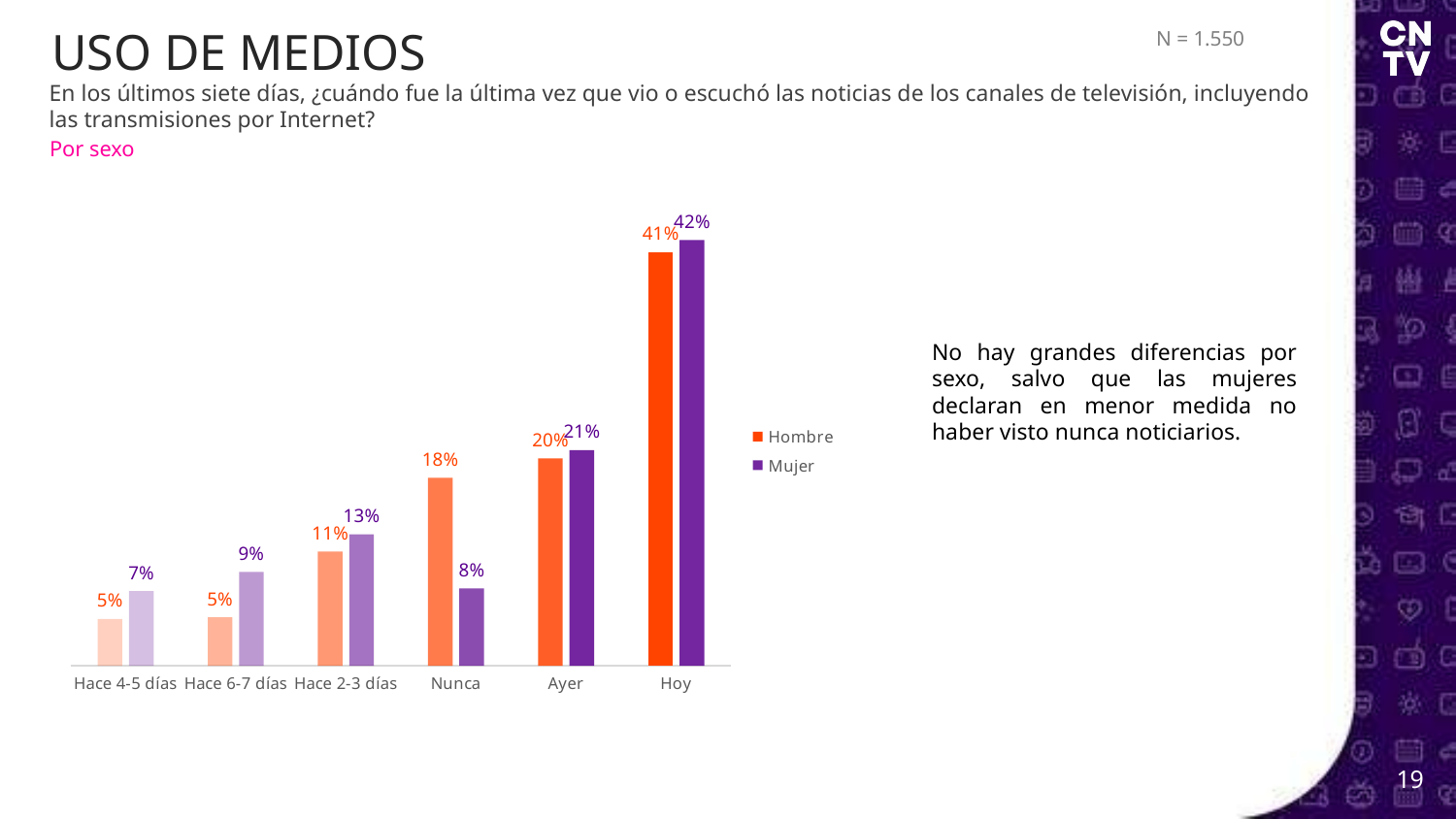
What is the value for Mujer in the Hace 2-3 días category? 13% How many categories are shown on the x axis? 6 Which category has the lowest value for Mujer? Hace 4-5 días What are the two series listed in the legend? Hombre and Mujer How many series does the legend list? 2 What kind of chart is shown on the slide? Bar chart Which is larger in the Hace 6-7 días category, Hombre or Mujer? Mujer What is the difference between Hombre and Mujer in the Nunca category? 10% Which category has the highest value for Hombre? Hoy What is the value for Hombre in the Nunca category? 18% What is the value for Mujer in the Hoy category? 42% What is the value for Hombre in the Ayer category? 20%